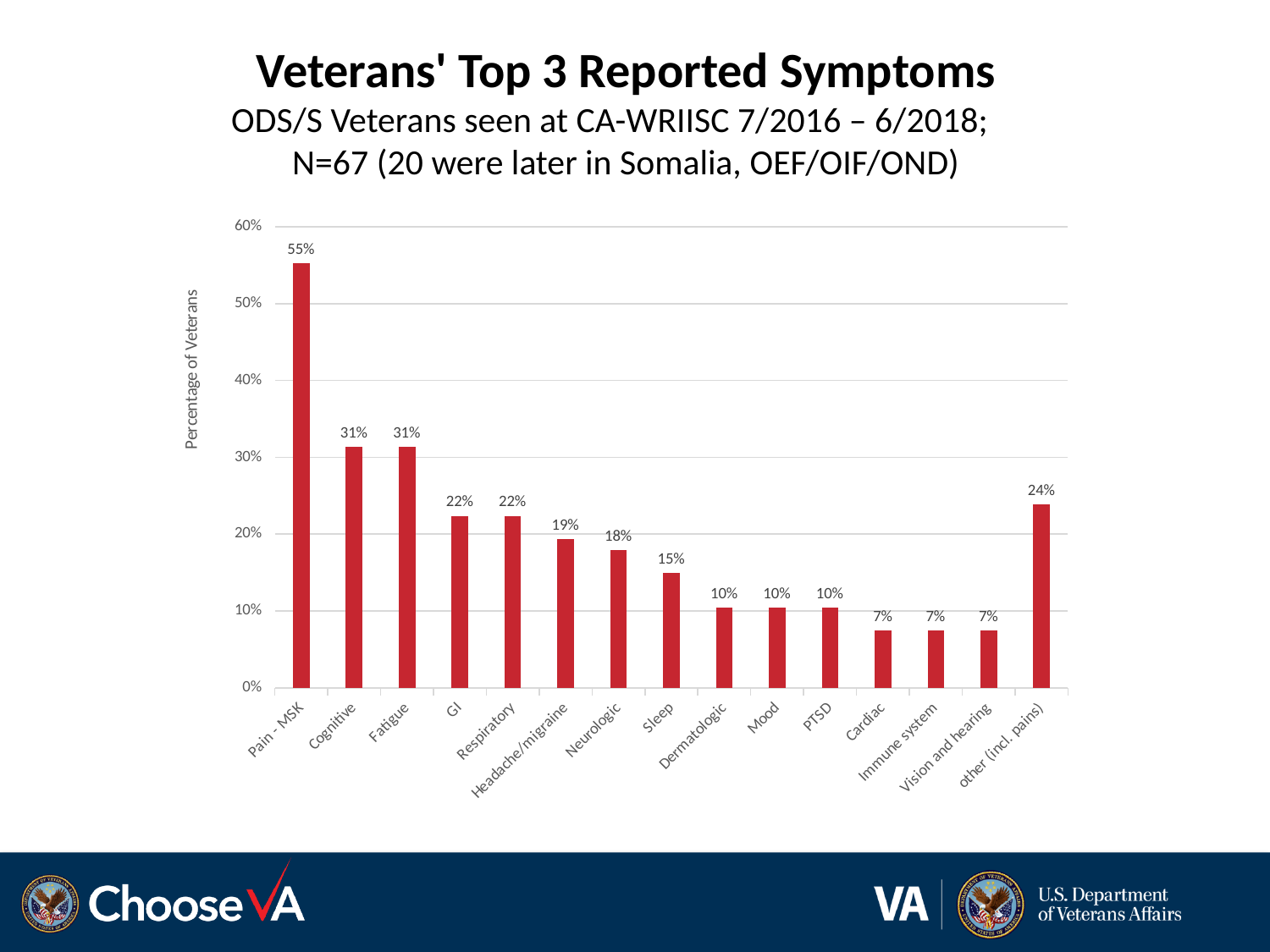
Which is larger, the value for Respiratory or the value for Neurologic? Respiratory Which symptom category has the highest percentage? Pain - MSK What percentage of Veterans reported Pain - MSK as a top 3 symptom? 55% What is the value for other (incl. pains)? 24% What is the label of the y axis? Percentage of Veterans What is the difference between the values for Pain - MSK and Cognitive? 24% What is the value for Headache/migraine? 19% How many symptom categories are shown on the x axis? 15 Is the value for Cardiac greater or less than 10%? less What is the value for Sleep? 15% What kind of chart is shown on the slide? Bar chart What is the difference between the values for Neurologic and Sleep? 3%